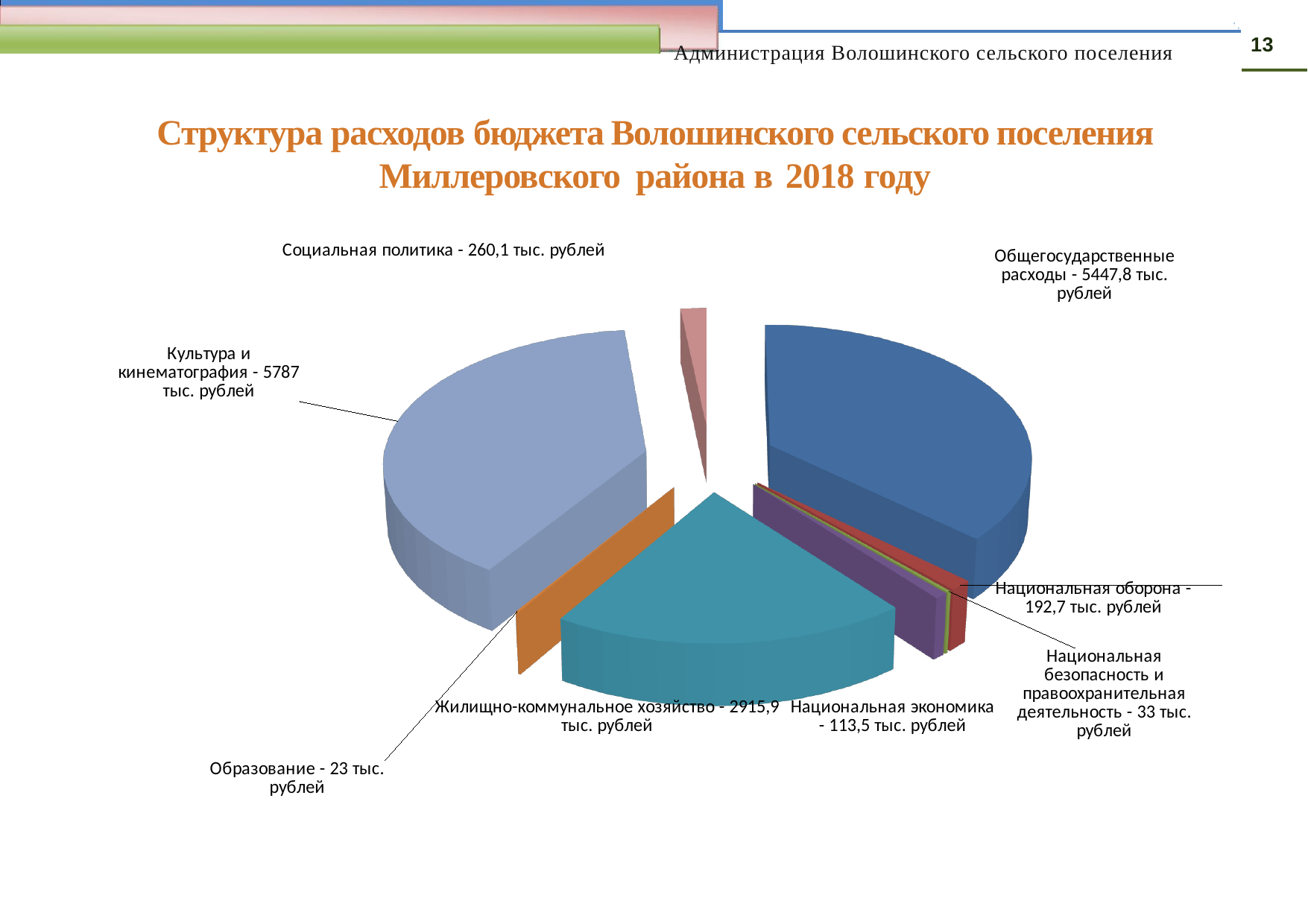
What is the value for Социальная политика? 260,1 тыс. рублей What is the value for Общегосударственные расходы? 5447,8 тыс. рублей Which is larger: Национальная оборона or Социальная политика? Социальная политика What is the value for Национальная безопасность и правоохранительная деятельность? 33 тыс. рублей Which category has the smallest value in the pie chart? Образование What kind of chart is shown on the slide? Pie chart What year does the chart title say the budget expenditure structure refers to? 2018 How many categories (slices) does the pie chart show? 8 What is the difference between Национальная оборона and Национальная экономика? 79,2 тыс. рублей What is the difference between Культура и кинематография and Общегосударственные расходы? 339,2 тыс. рублей What is the value for Жилищно-коммунальное хозяйство? 2915,9 тыс. рублей Which category has the largest value in the pie chart? Культура и кинематография